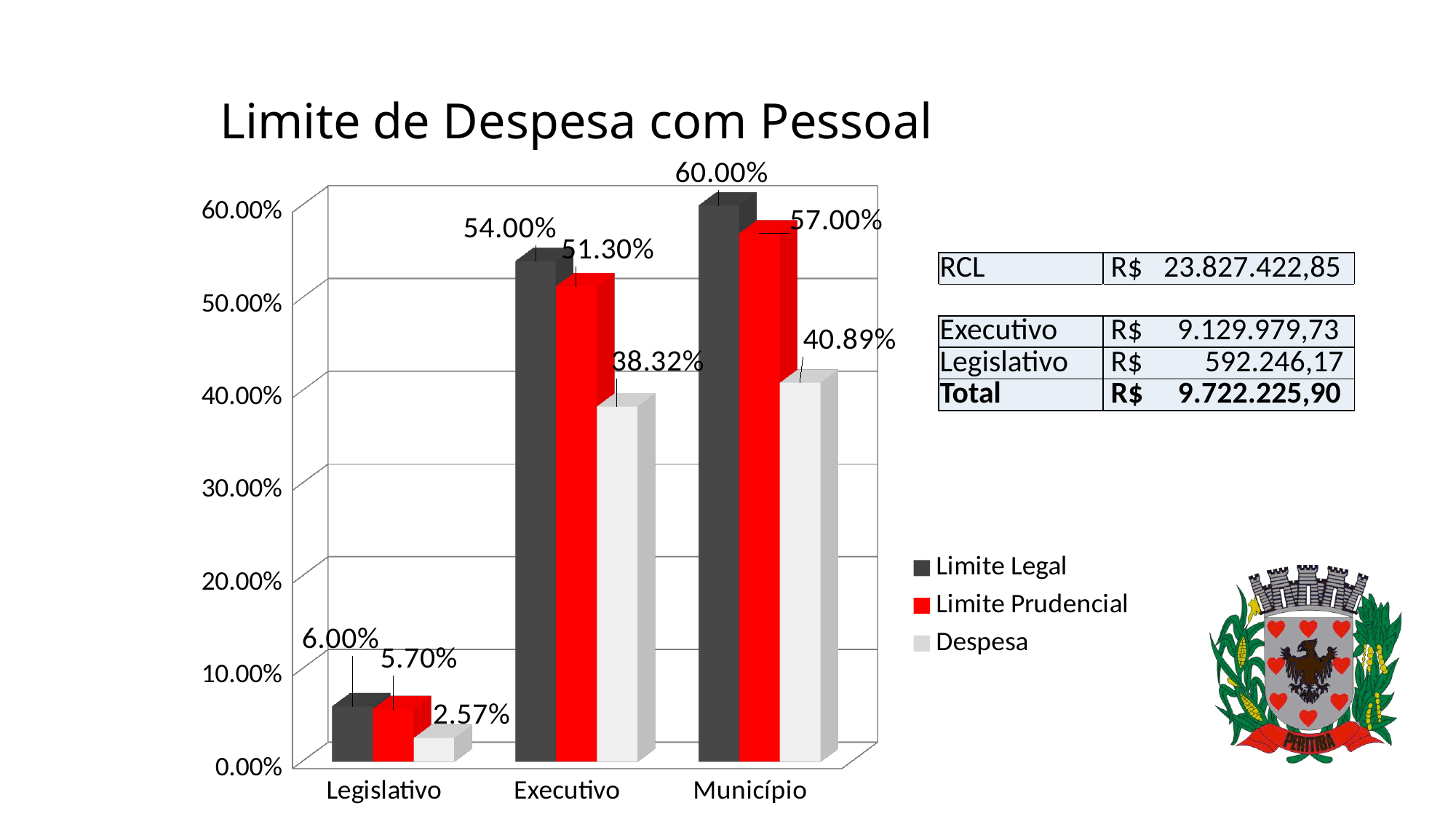
What is the Despesa value for Executivo? 38.32% How many series does the legend list? 3 Which is larger for Legislativo: Limite Prudencial or Despesa? Limite Prudencial What is the Despesa value for Município? 40.89% What is the difference between the Limite Legal and the Despesa for Executivo? 15.68% What is the title of the chart? Limite de Despesa com Pessoal Which category has the lowest Despesa value? Legislativo What is the Limite Prudencial value for Município? 57.00% What kind of chart is shown? Bar chart Which category has the highest Limite Legal value? Município What is the Limite Legal value for Legislativo? 6.00% How many categories are shown on the x axis? 3